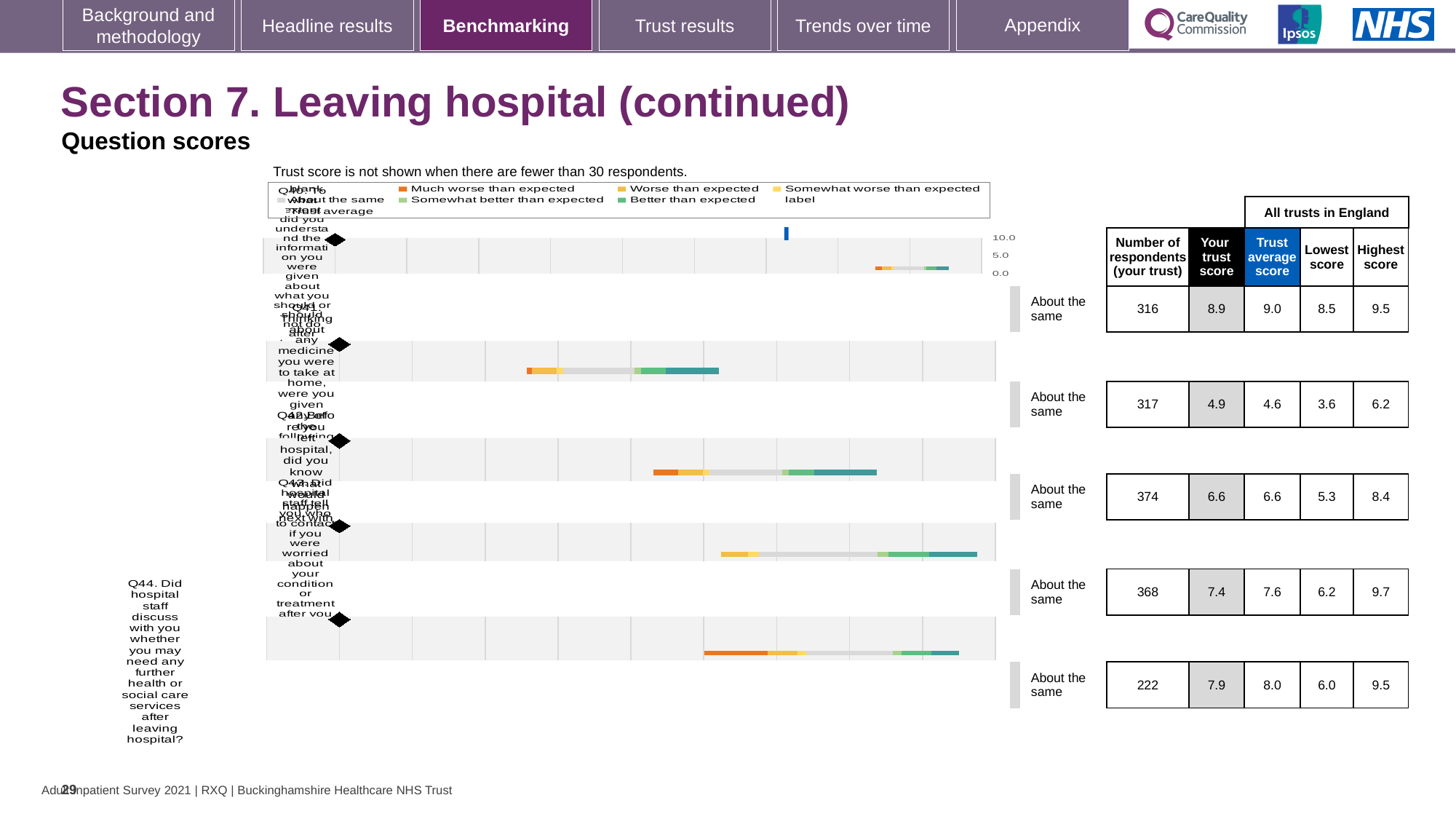
Which row has the highest 'Your trust score', and what is it? The top row, 8.9 What is the maximum value shown on the chart's score axis? 10.0 How many question rows (bars) are plotted in the chart? 5 For the bottom row (Q44), which is larger: the trust's own score or the trust average score? Trust average score (8.0) Which row has the lowest 'Your trust score', and what is it? The second row, 4.9 What benchmark category is shown for every question row on this slide? About the same For the bottom row (Q44), what is the trust average score? 8.0 For the bottom row (Q44, further health or social care services after leaving hospital), what is the 'Your trust score'? 7.9 What kind of chart is used to show the question scores on this slide? bar chart In the chart legend, which colour represents 'Much worse than expected'? orange For the bottom row (Q44), how many respondents did the trust have? 222 For the bottom row (Q44), what is the difference between the highest score (9.5) and the lowest score (6.0) across all trusts in England? 3.5